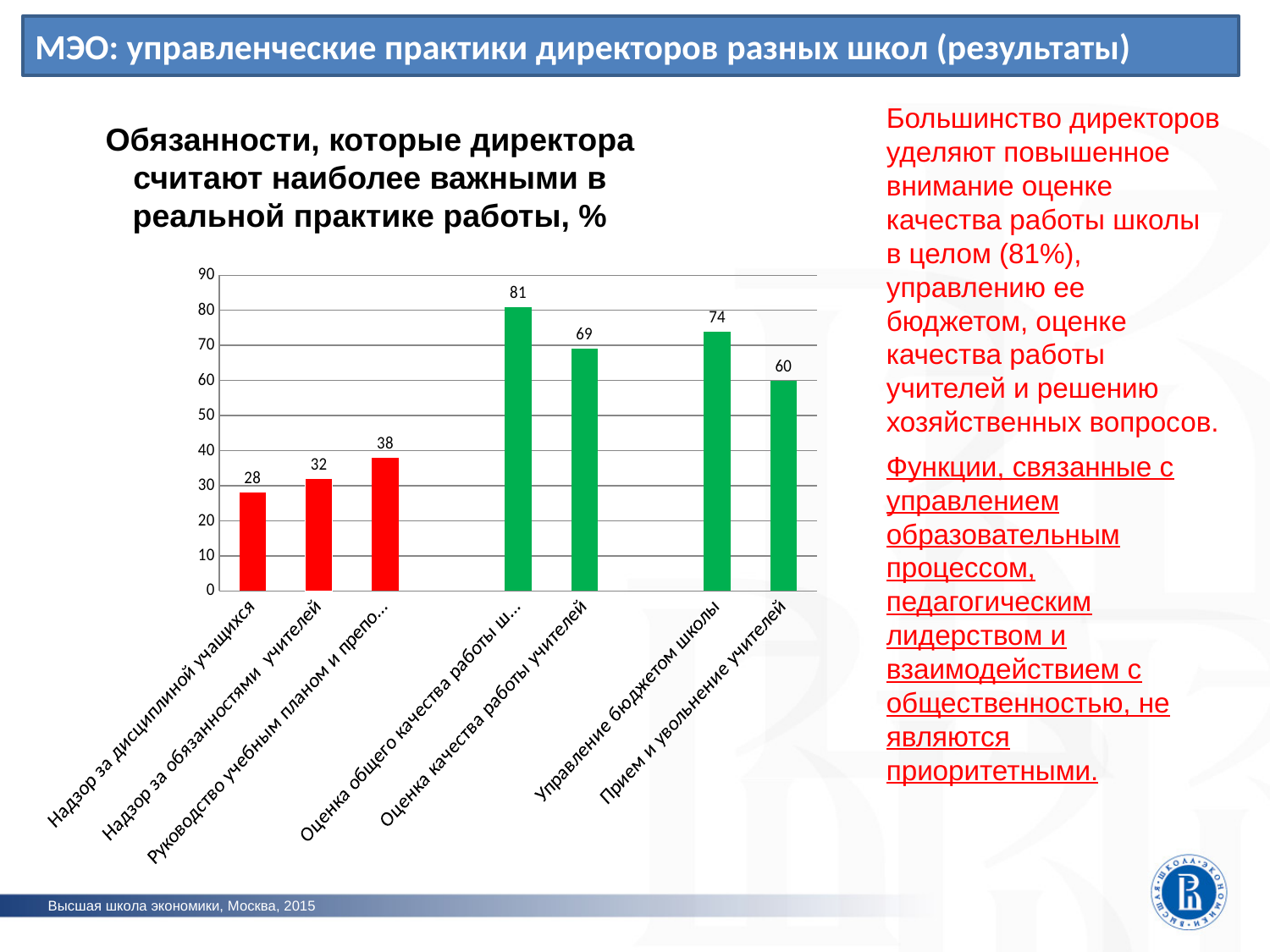
Which is larger: the value for "Оценка качества работы учителей" or the value for "Управление бюджетом школы"? Управление бюджетом школы What type of chart is shown on the slide? bar chart Which category has the lowest value in the chart? Надзор за дисциплиной учащихся Which category has the highest value in the chart? Оценка общего качества работы ш... What colour are the three bars with the lowest values? red What is the value for "Надзор за обязанностями учителей"? 32 What is the value for "Управление бюджетом школы"? 74 What is the difference between the values for "Управление бюджетом школы" and "Прием и увольнение учителей"? 14 How many bars (categories) are plotted in the chart? 7 What is the value for "Прием и увольнение учителей"? 60 What is the value for "Оценка качества работы учителей"? 69 What is the value for "Надзор за дисциплиной учащихся"? 28